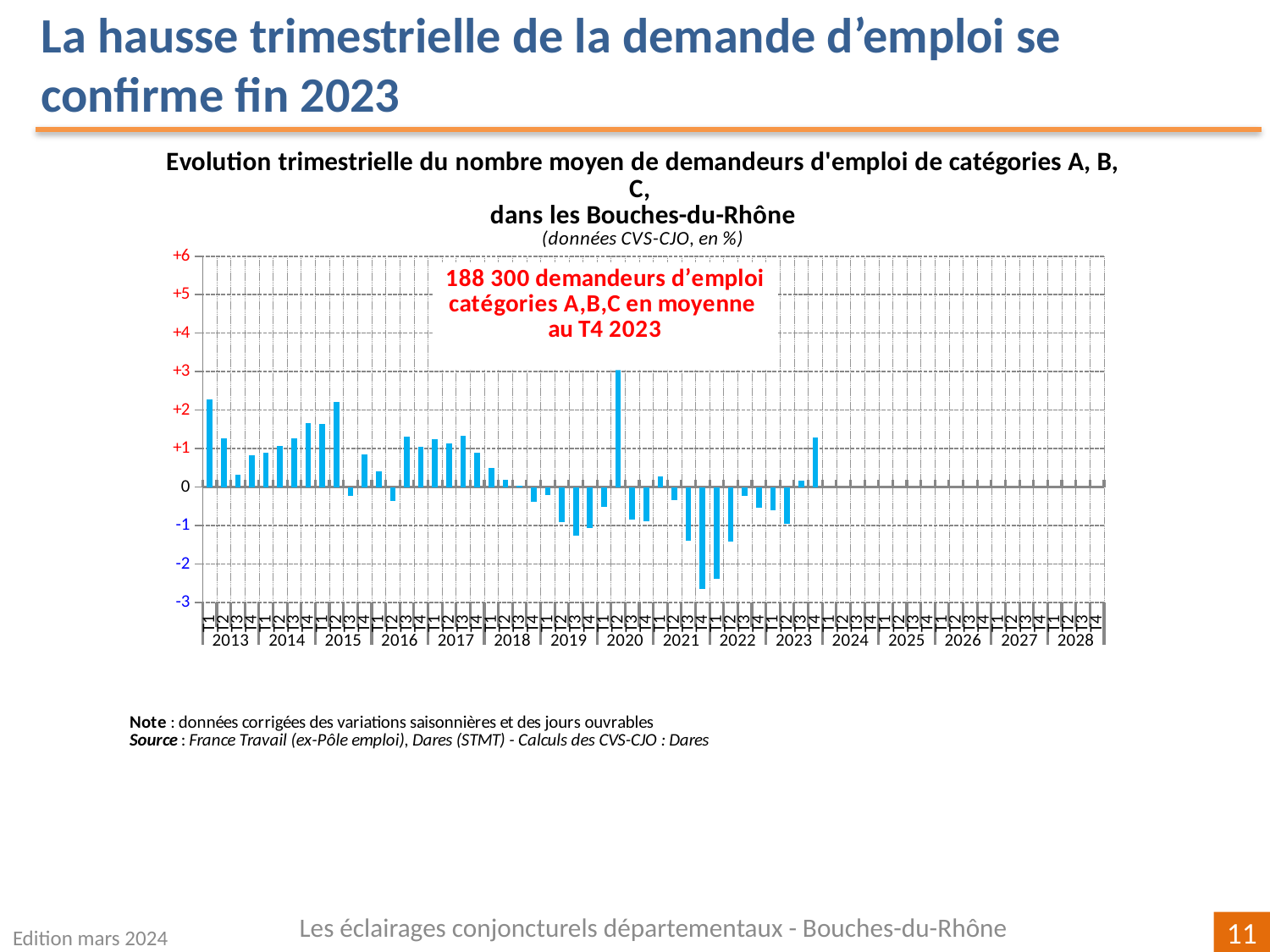
Is the value for T1 2013 greater or less than +2? greater What kind of chart is shown on the slide? bar chart How many years are labelled on the x axis? 16 Which is larger, the value for T1 2013 or the value for T2 2013? T1 2013 According to the annotation on the chart, how many demandeurs d'emploi catégories A,B,C were there on average in T4 2023? 188 300 Is the value for T3 2019 greater or less than -1? less Is the value for T2 2020 greater or less than +2? greater Which quarter has the highest bar in the chart? T2 2020 From T1 2019 to T3 2019, do the values rise or fall? fall Which is larger, the value for T2 2020 or the value for T2 2015? T2 2020